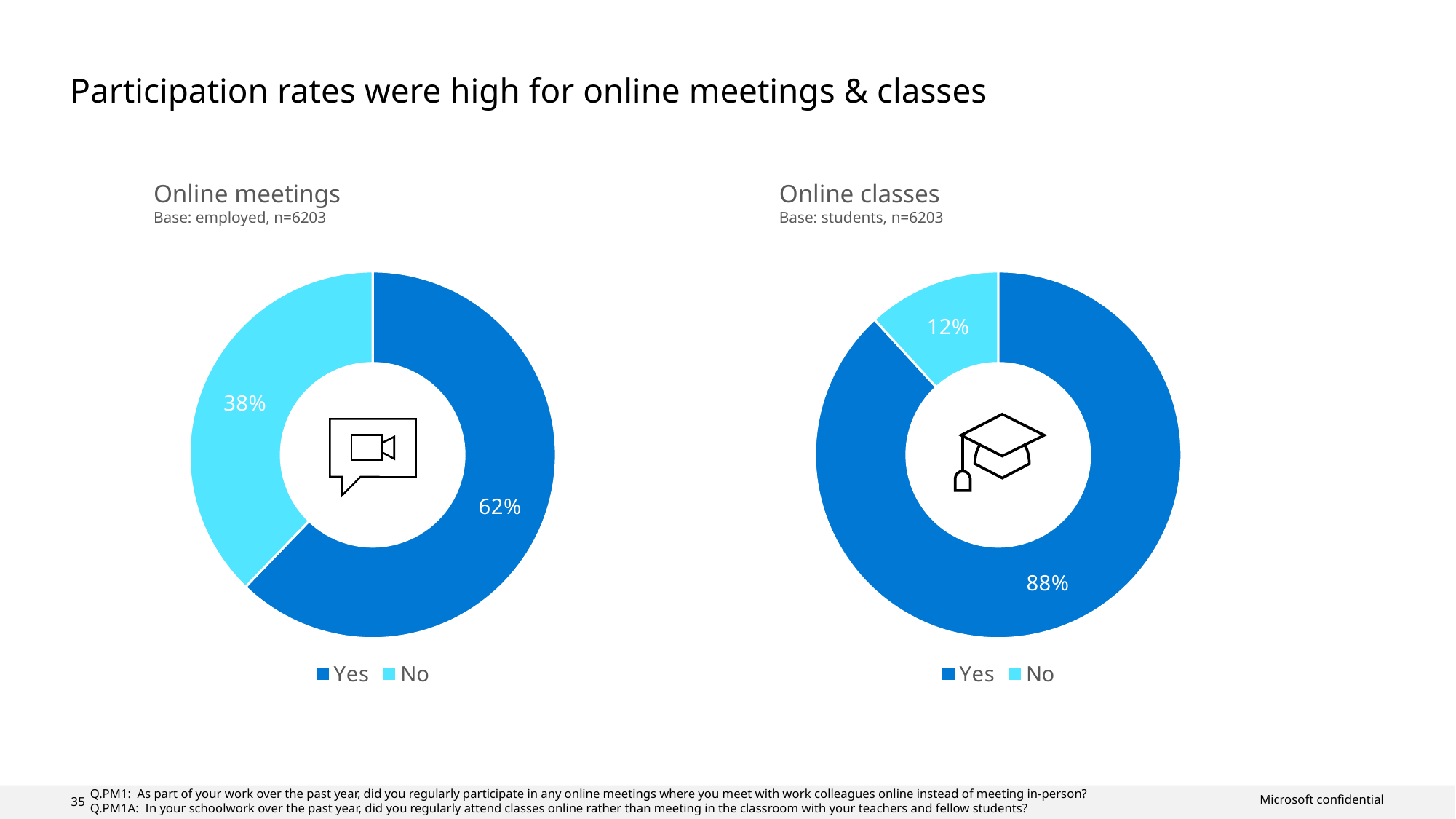
In the Online classes chart, what percentage answered No? 12% What is the base described under the Online classes chart title? Base: students, n=6203 In the Online classes chart, what percentage answered Yes? 88% In the Online meetings chart, which response has the smallest share? No In the Online classes chart, what is the difference between the Yes and No percentages? 76% In the Online classes chart, which response has the largest share? Yes In the Online meetings chart, what is the difference between the Yes and No percentages? 24% Which chart has the larger Yes share, Online meetings or Online classes? Online classes In the Online meetings chart, what percentage answered Yes? 62% What kind of chart is the Online meetings chart? Pie chart (donut) In the Online meetings chart, what percentage answered No? 38% How many entries does the legend of the Online classes chart list? 2